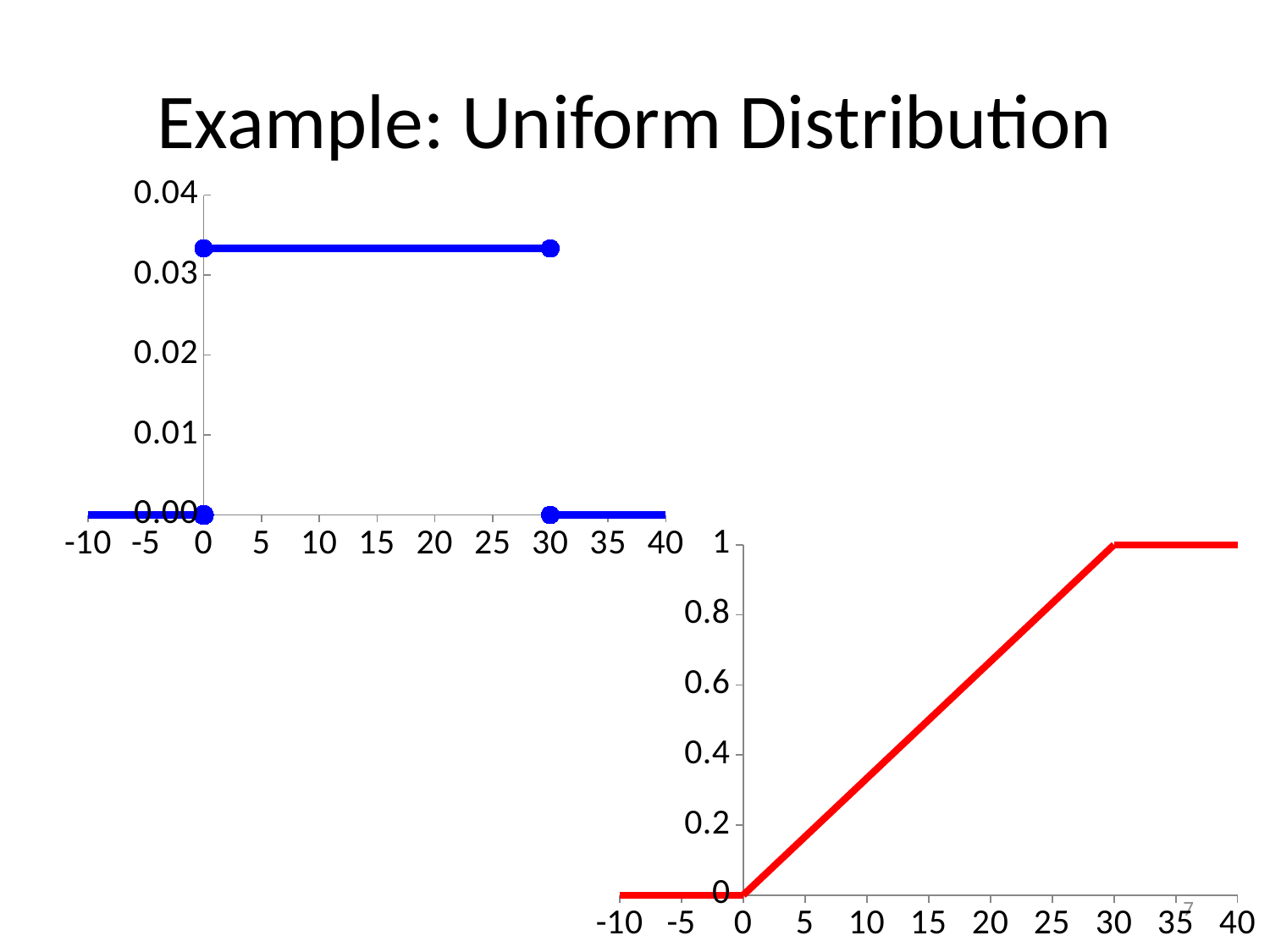
In the bottom-right chart, is the value at x = 15 greater or less than 0.4? greater In the top-left chart, is the value at x = 15 greater or less than 0.03? greater In the bottom-right chart, what is the value at x = 30? 1 In the bottom-right chart, do the values rise or fall as x goes from 0 to 30? rise In the bottom-right chart, which is larger: the value at x = 10 or the value at x = 20? x = 20 In the bottom-right chart, what is the value at x = 40? 1 In the bottom-right chart, what is the value at x = -5? 0 In the top-left chart, is the value at x = 15 greater or less than 0.04? less In the top-left chart, what is the value at x = -5? 0.00 What kind of chart is the top-left chart on the slide? line chart What colour is the line in the top-left chart? blue What kind of chart is the bottom-right chart on the slide? line chart